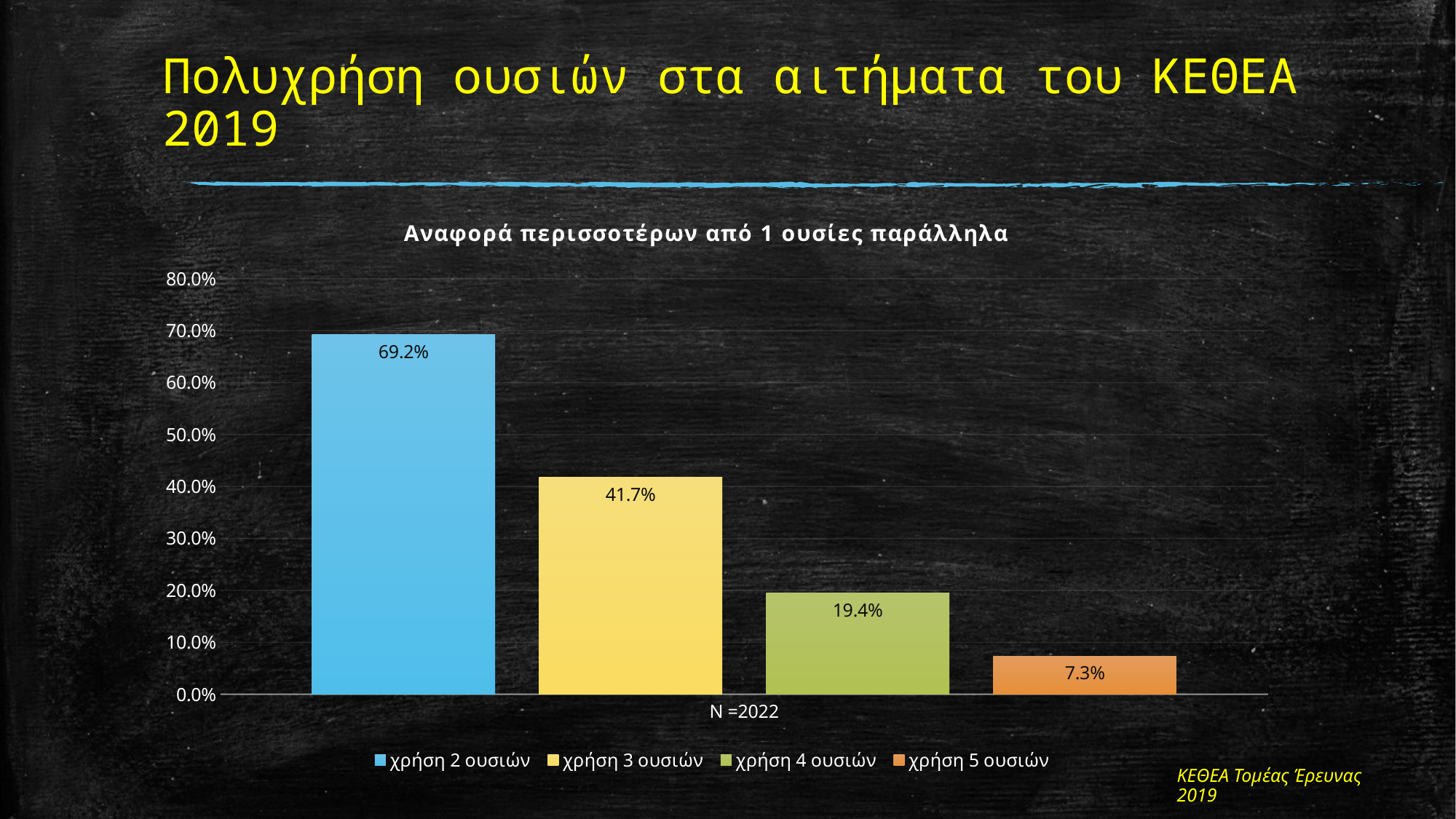
What kind of chart is shown on the slide? bar chart What is the title of the chart? Αναφορά περισσοτέρων από 1 ουσίες παράλληλα Which series has the highest value? χρήση 2 ουσιών Which is larger, the value for χρήση 4 ουσιών or χρήση 5 ουσιών? χρήση 4 ουσιών What is the value for χρήση 3 ουσιών? 41.7% What is the value for χρήση 2 ουσιών? 69.2% What is the difference between the values for χρήση 2 ουσιών and χρήση 3 ουσιών? 27.5% Is the value for χρήση 3 ουσιών greater or less than 40.0%? greater How many series does the legend list? 4 What is the value for χρήση 5 ουσιών? 7.3% What is the value for χρήση 4 ουσιών? 19.4% Which series has the lowest value? χρήση 5 ουσιών